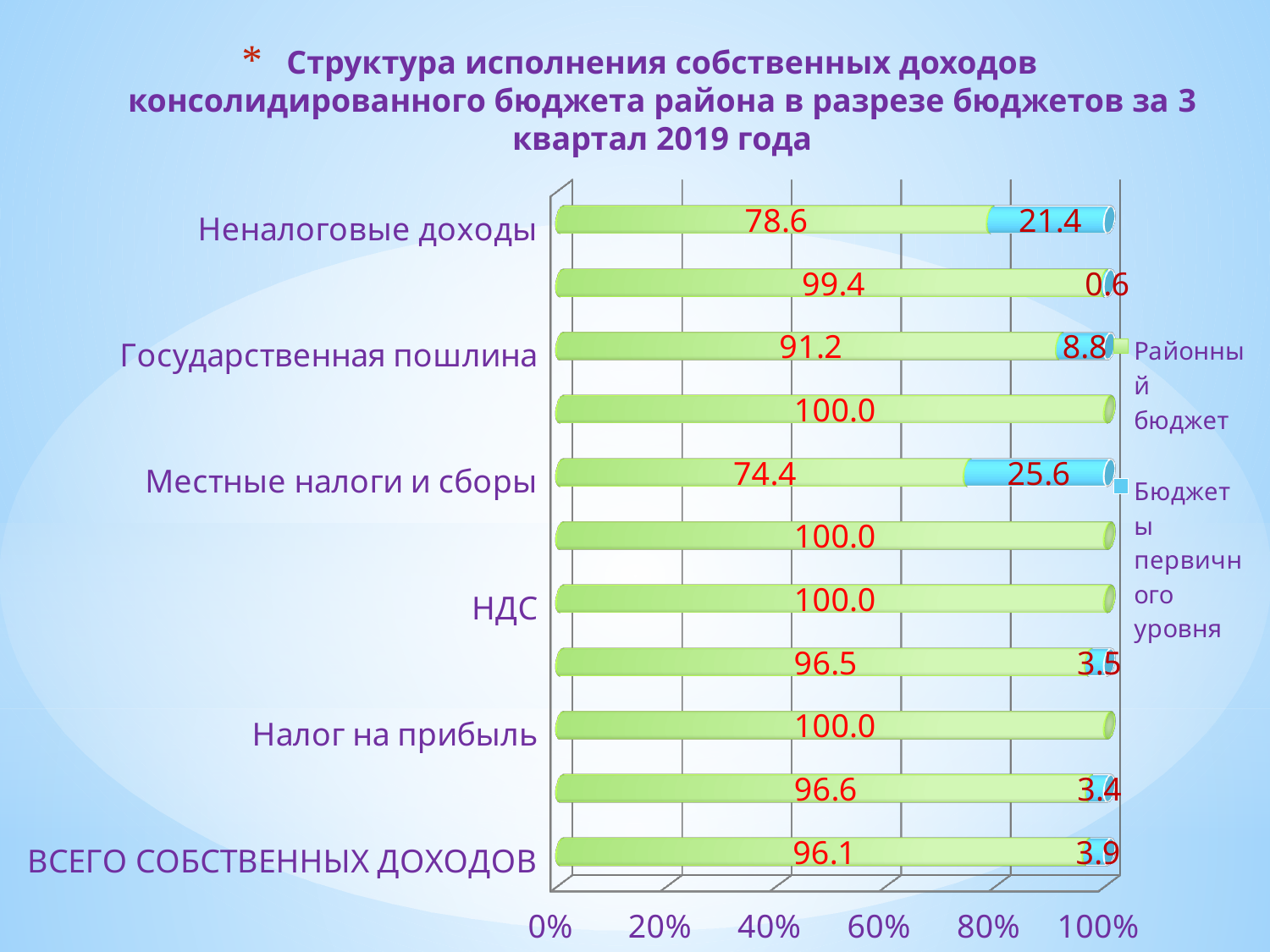
What is the value of Бюджеты первичного уровня for Местные налоги и сборы? 25.6 Which is larger: the Бюджеты первичного уровня value for Неналоговые доходы or for Государственная пошлина? Неналоговые доходы What is the value of Районный бюджет for НДС? 100.0 What is the value of Бюджеты первичного уровня for Государственная пошлина? 8.8 Among the labelled categories, which has the lowest Районный бюджет share? Местные налоги и сборы Which series is shown in green? Районный бюджет How many series does the legend list? 2 What is the value of Районный бюджет for ВСЕГО СОБСТВЕННЫХ ДОХОДОВ? 96.1 What is the difference between the Районный бюджет values for Неналоговые доходы and Местные налоги и сборы? 4.2 What kind of chart is shown on the slide? Stacked bar chart What is the value of Районный бюджет for Неналоговые доходы? 78.6 What is the total of the stacked bar for Местные налоги и сборы? 100.0